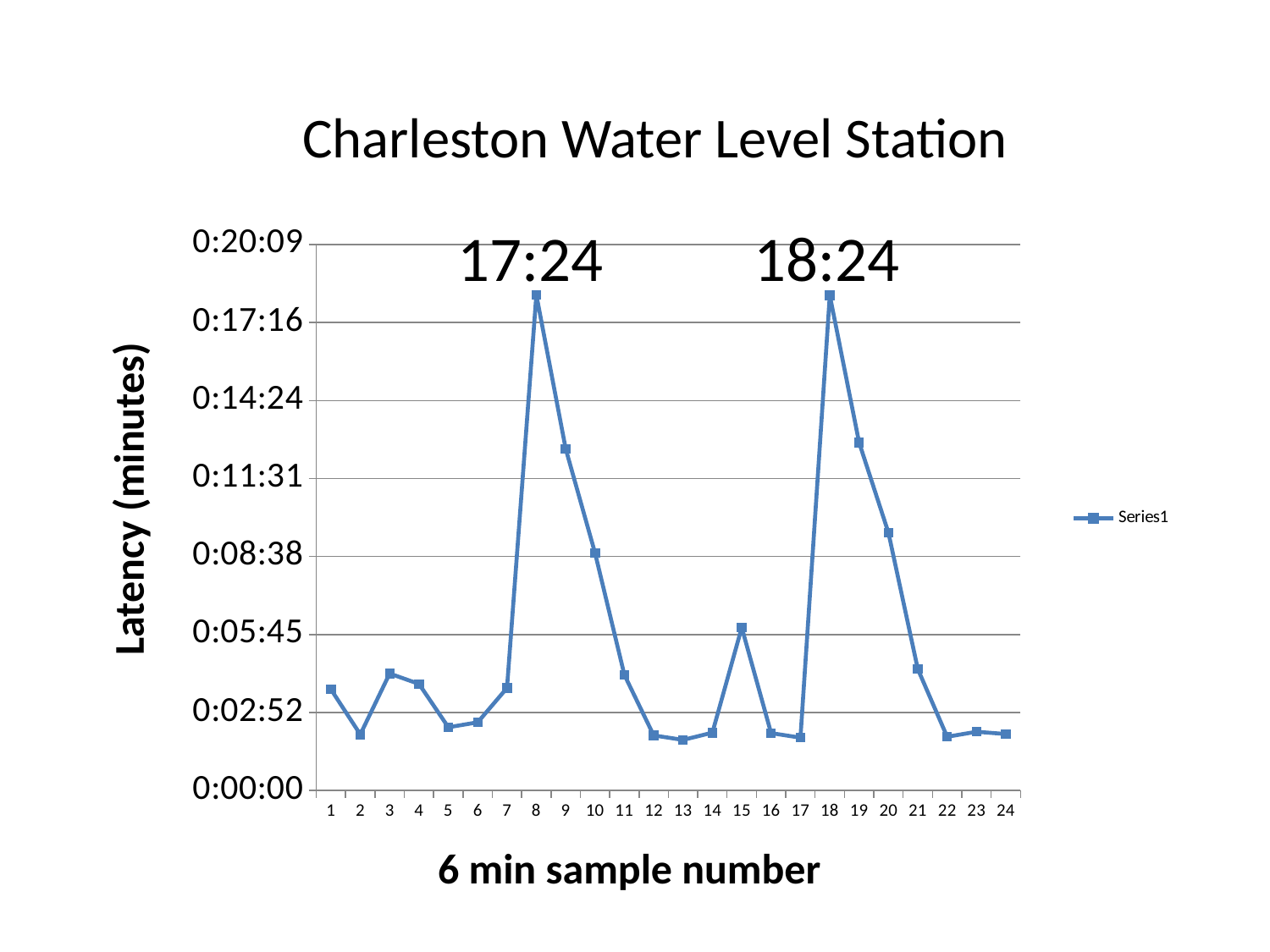
How many sample points are plotted along the x axis? 24 Is the value for sample number 8 greater or less than 0:17:16? greater Which has the larger latency, sample number 9 or sample number 10? sample number 9 How many series does the legend list? 1 What kind of chart is shown on the slide? line chart Is the value for sample number 10 greater or less than 0:05:45? greater Which has the larger latency, sample number 15 or sample number 16? sample number 15 Is the value for sample number 20 greater or less than 0:08:38? greater What is the title of the chart? Charleston Water Level Station Do the values rise or fall from sample number 8 to sample number 12? fall What is the label of the vertical axis? Latency (minutes)